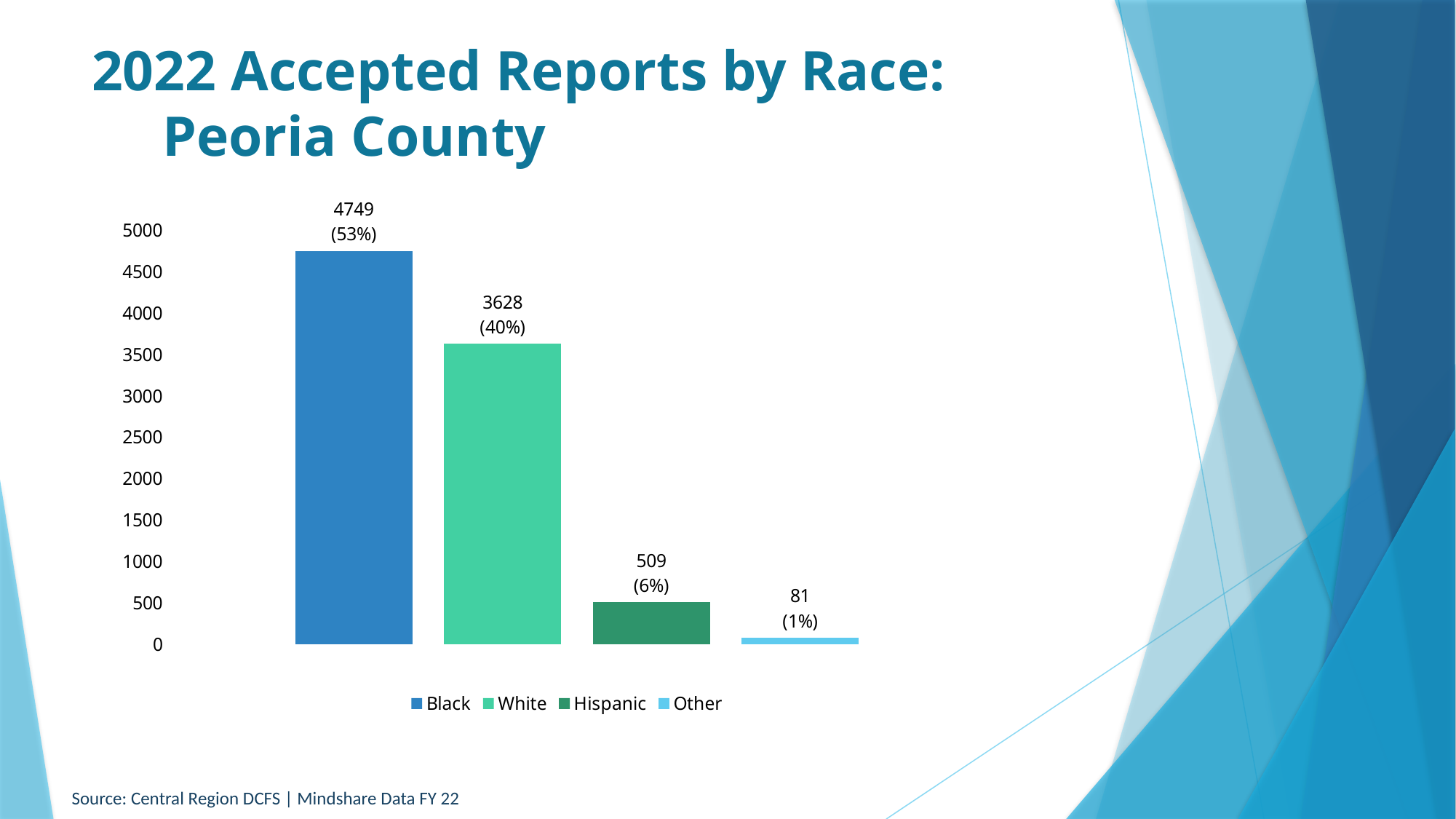
What percentage of accepted reports is shown for White? 40% How many categories does the legend list? 4 What is the title of the slide? 2022 Accepted Reports by Race: Peoria County What kind of chart is shown on the slide? Bar chart Which category has the lowest number of accepted reports? Other What is the number of accepted reports for Black? 4749 Which category has the highest number of accepted reports? Black Which is larger, the value for Hispanic or the value for Other? Hispanic What is the number of accepted reports for Hispanic? 509 What is the number of accepted reports for White? 3628 What is the number of accepted reports for Other? 81 What is the difference between the Black and White values? 1121